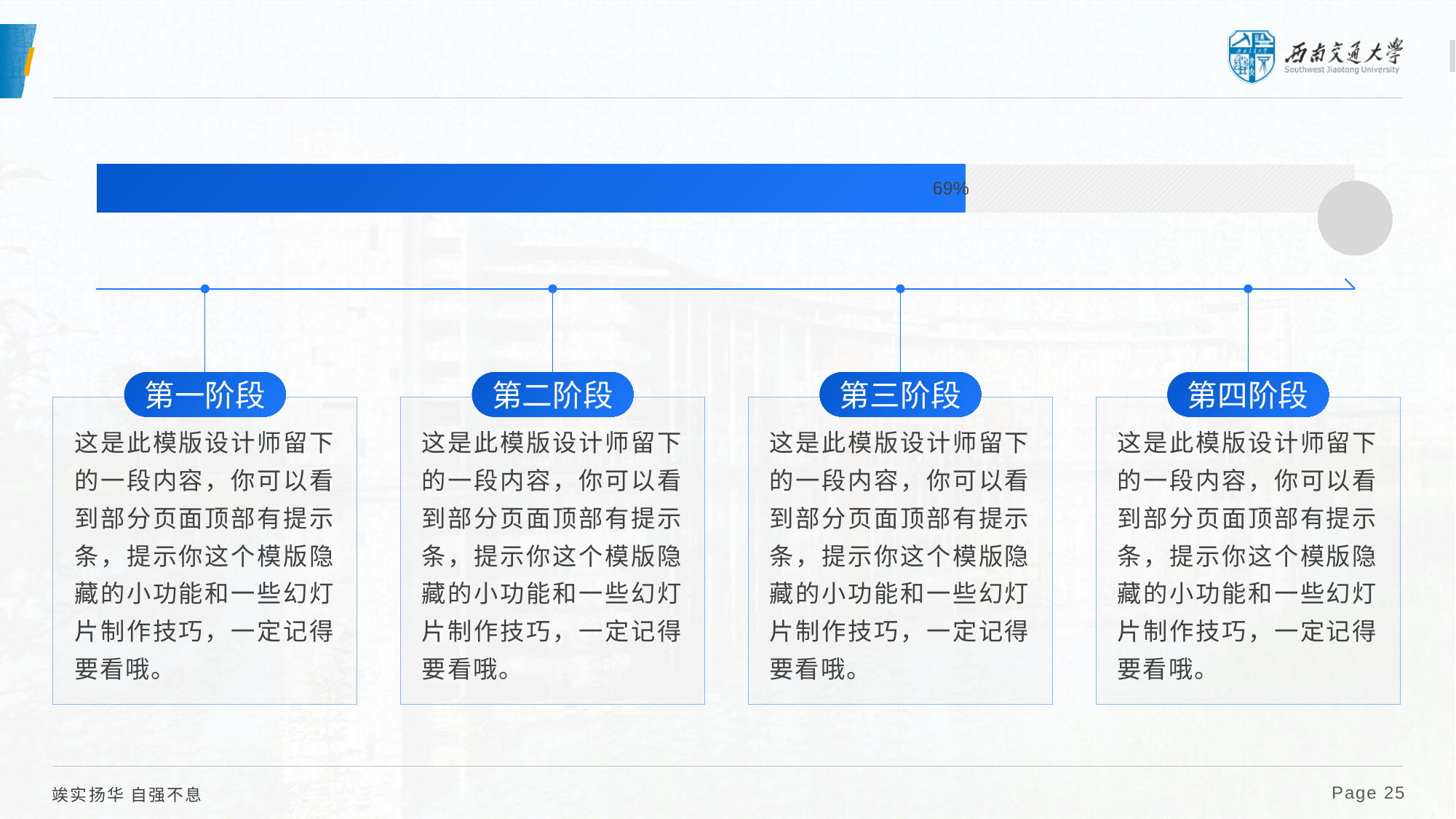
What kind of chart is shown at the top of the slide? bar chart What is the label of the first stage on the timeline? 第一阶段 How many bars are plotted in the chart at the top of the slide? 2 How many stages (阶段) are marked on the timeline below the progress bar? 4 Is the value shown on the progress bar greater or less than 100%? less What percentage value is printed on the horizontal progress bar at the top of the slide? 69% What colour is the filled portion of the progress bar? blue Is the value shown on the progress bar greater or less than 50%? greater